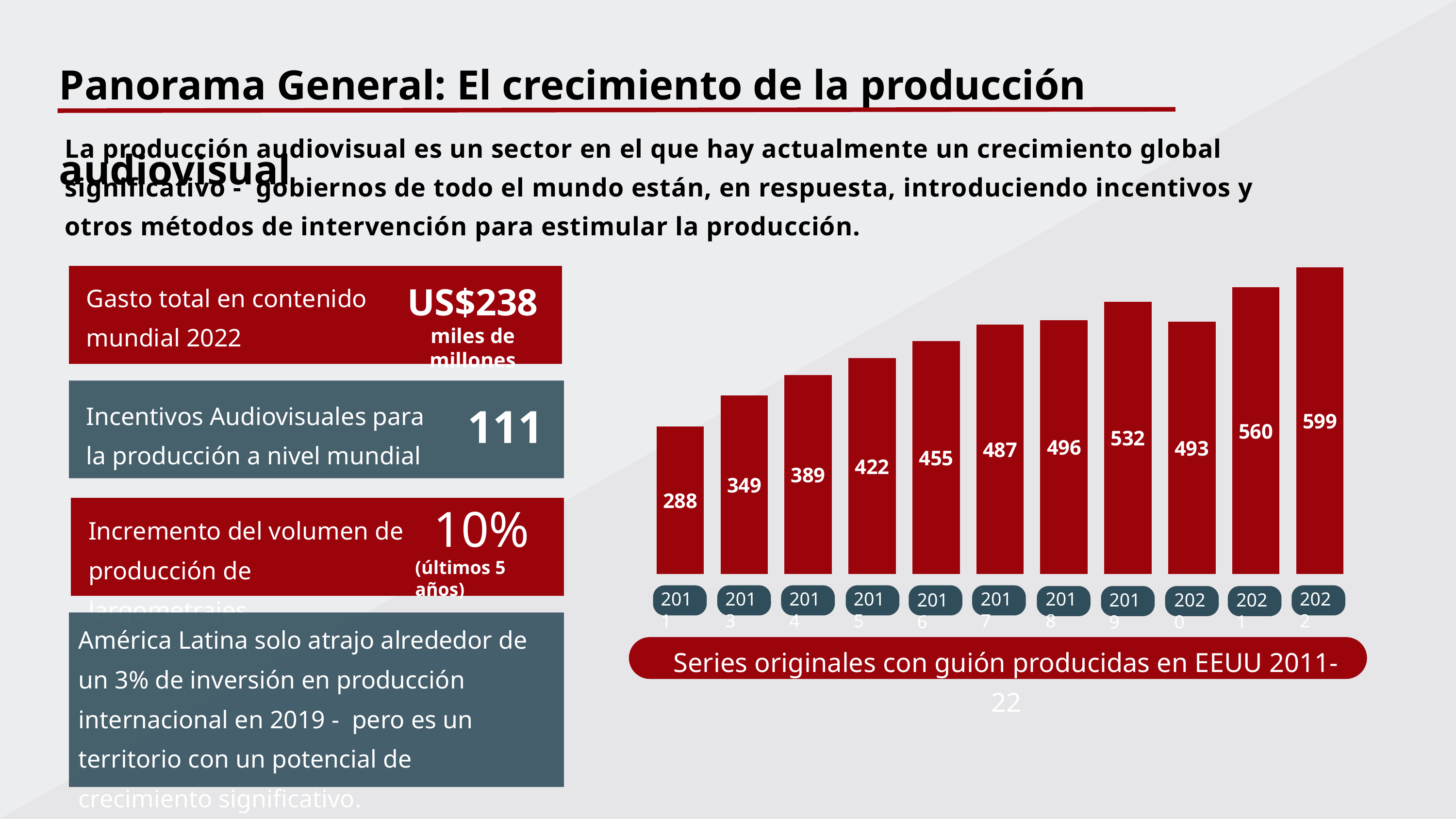
Which year has the lowest value in the chart? 2011 Which is larger, the value for 2019 or the value for 2020? 2019 What is the difference between the values for 2022 and 2011? 311 What is the difference between the values for 2021 and 2020? 67 Which year has the highest value in the chart? 2022 What is the value for 2019 in the chart? 532 Do the values in the chart generally rise or fall from 2011 to 2022? Rise What is the value for 2011 in the chart? 288 What is the value for 2020 in the chart? 493 How many bars are shown in the chart? 11 What kind of chart is shown on the slide? Bar chart What is the title of the chart? Series originales con guión producidas en EEUU 2011-22